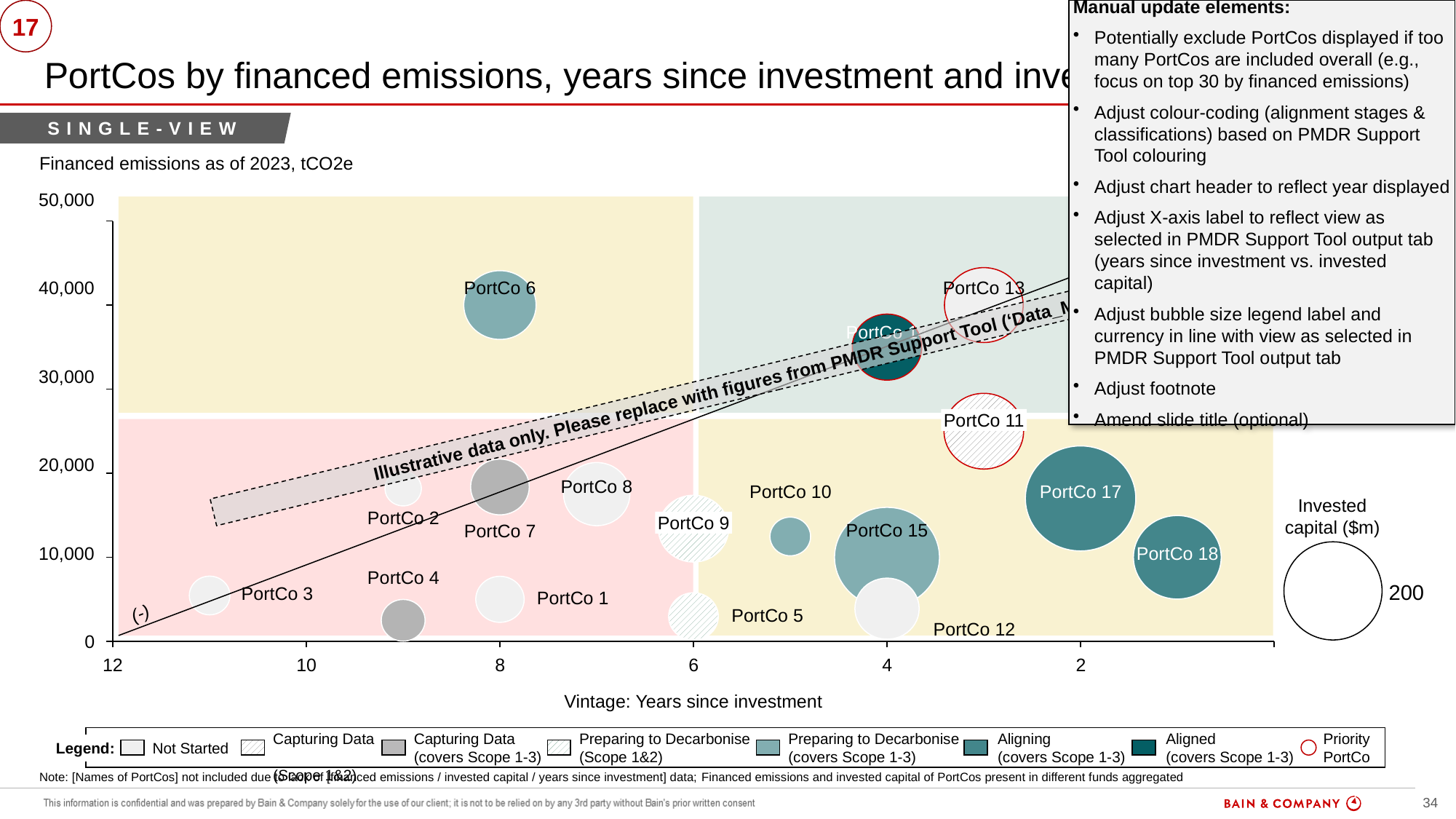
What does the bubble size in the chart represent? Invested capital ($m) Is the financed emissions value for PortCo 13 greater or less than 30,000? greater Which has higher financed emissions, PortCo 17 or PortCo 18? PortCo 17 Is the financed emissions value for PortCo 12 greater or less than 10,000? less Is the financed emissions value for PortCo 10 greater or less than 20,000? less Which has higher financed emissions, PortCo 11 or PortCo 12? PortCo 11 What kind of chart is shown on the slide? bubble chart Which has higher financed emissions, PortCo 6 or PortCo 3? PortCo 6 What is the label of the x axis of the chart? Vintage: Years since investment